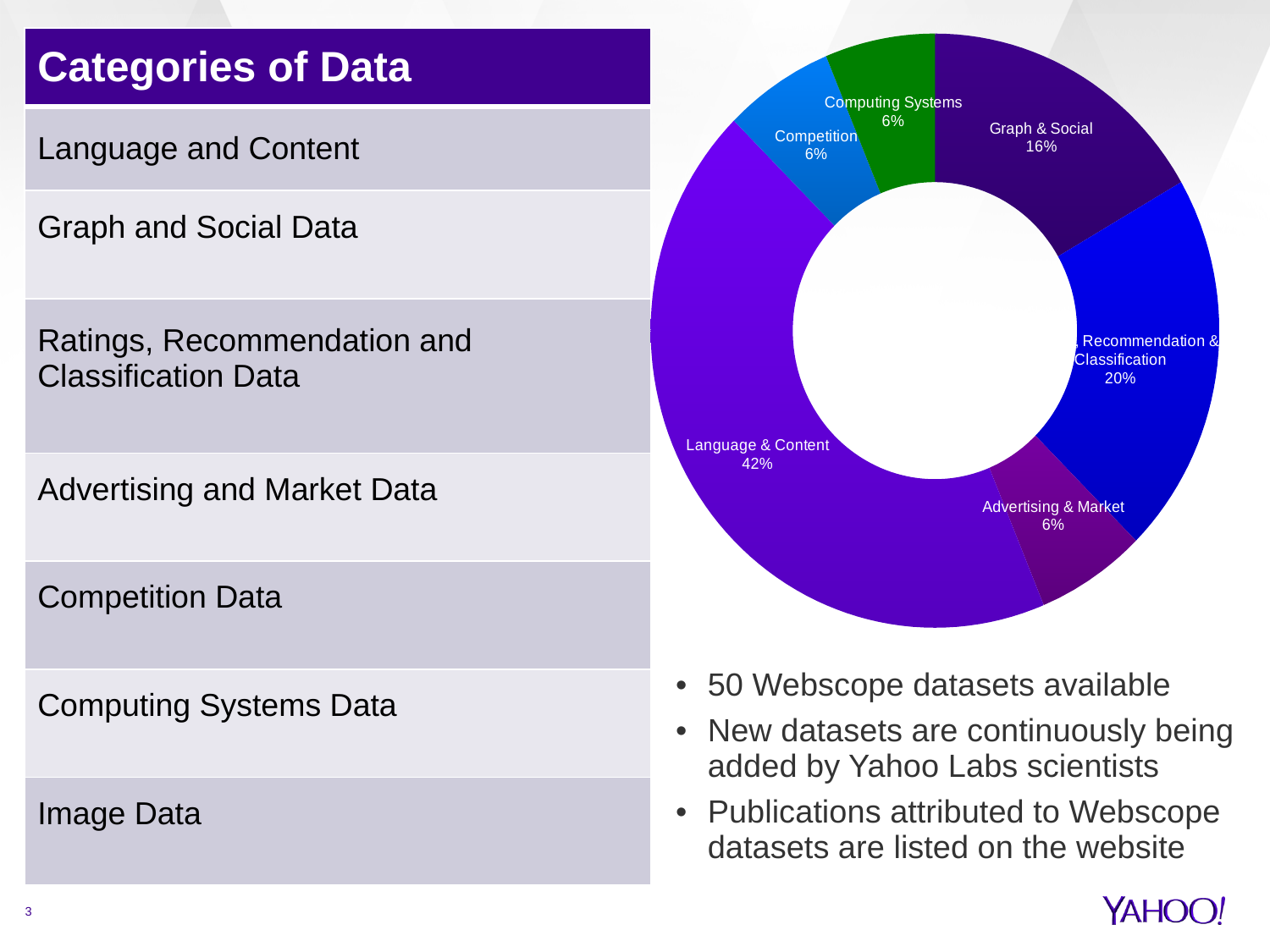
What share of the doughnut chart is Computing Systems? 6% Which category has the largest share in the doughnut chart? Language & Content Which is larger, the share for Graph & Social or the share for Recommendation & Classification? Recommendation & Classification What share of the doughnut chart is Recommendation & Classification? 20% How many slices does the doughnut chart have? 6 What share of the doughnut chart is Language & Content? 42% What share of the doughnut chart is Advertising & Market? 6% What colour is the Computing Systems slice in the doughnut chart? Green What is the combined share of Competition, Computing Systems and Advertising & Market? 18% What kind of chart is shown on the slide? Doughnut chart What is the difference in percentage points between Language & Content and Graph & Social? 26 What share of the doughnut chart is Graph & Social? 16%